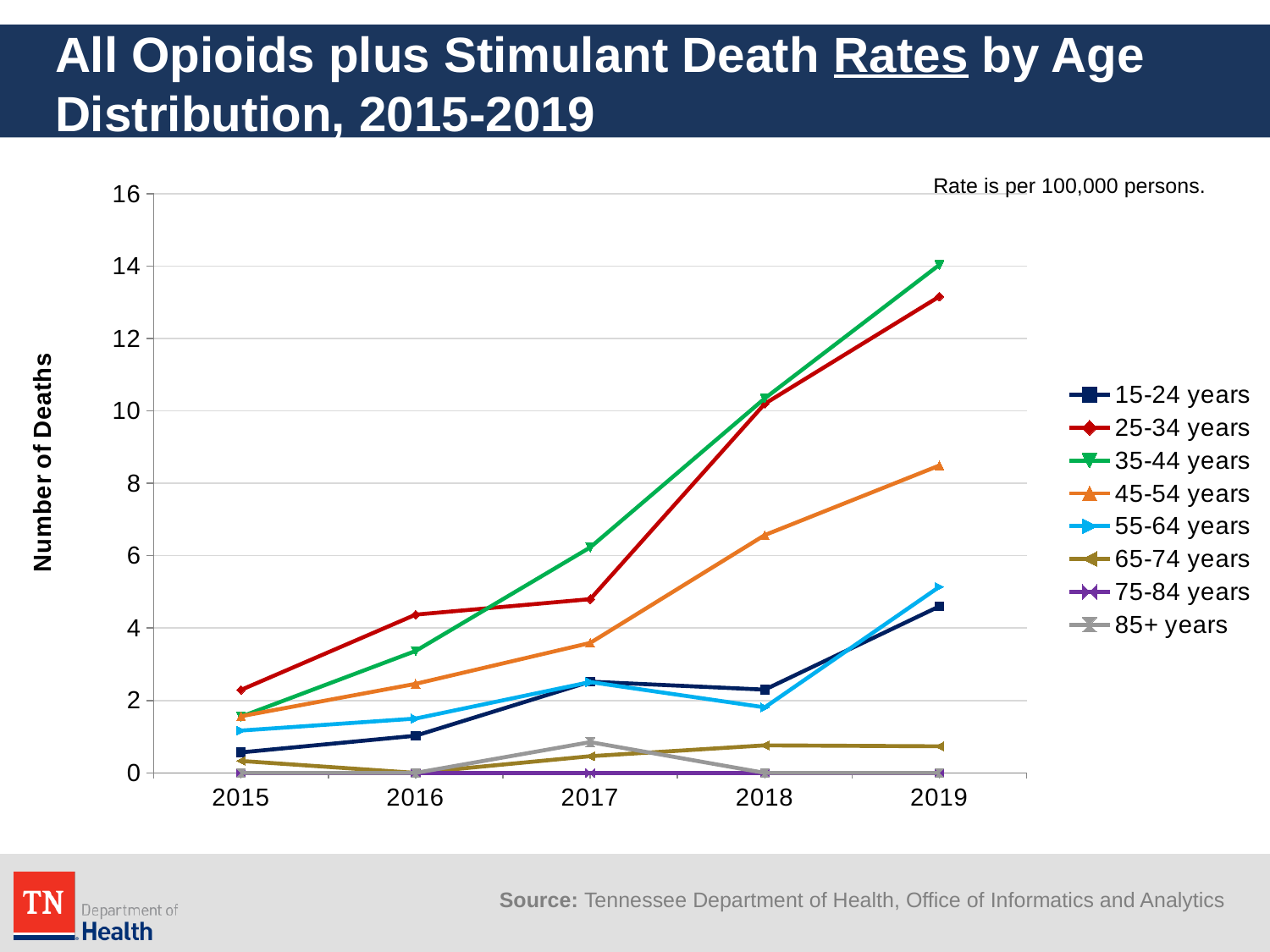
Is the value for 45-54 years in 2019 greater or less than 10? less Which age group has the highest rate in 2015? 25-34 years How many years are plotted along the x axis? 5 What kind of chart is shown on the slide? line chart What is the title of the y axis? Number of Deaths Is the value for 35-44 years in 2019 greater or less than 12? greater In 2017, which is larger: the value for 35-44 years or for 25-34 years? 35-44 years How many series does the legend list? 8 Is the value for 25-34 years in 2017 greater or less than 6? less Does the rate for 35-44 years rise or fall from 2015 to 2019? rise Which age group has the highest rate in 2019? 35-44 years